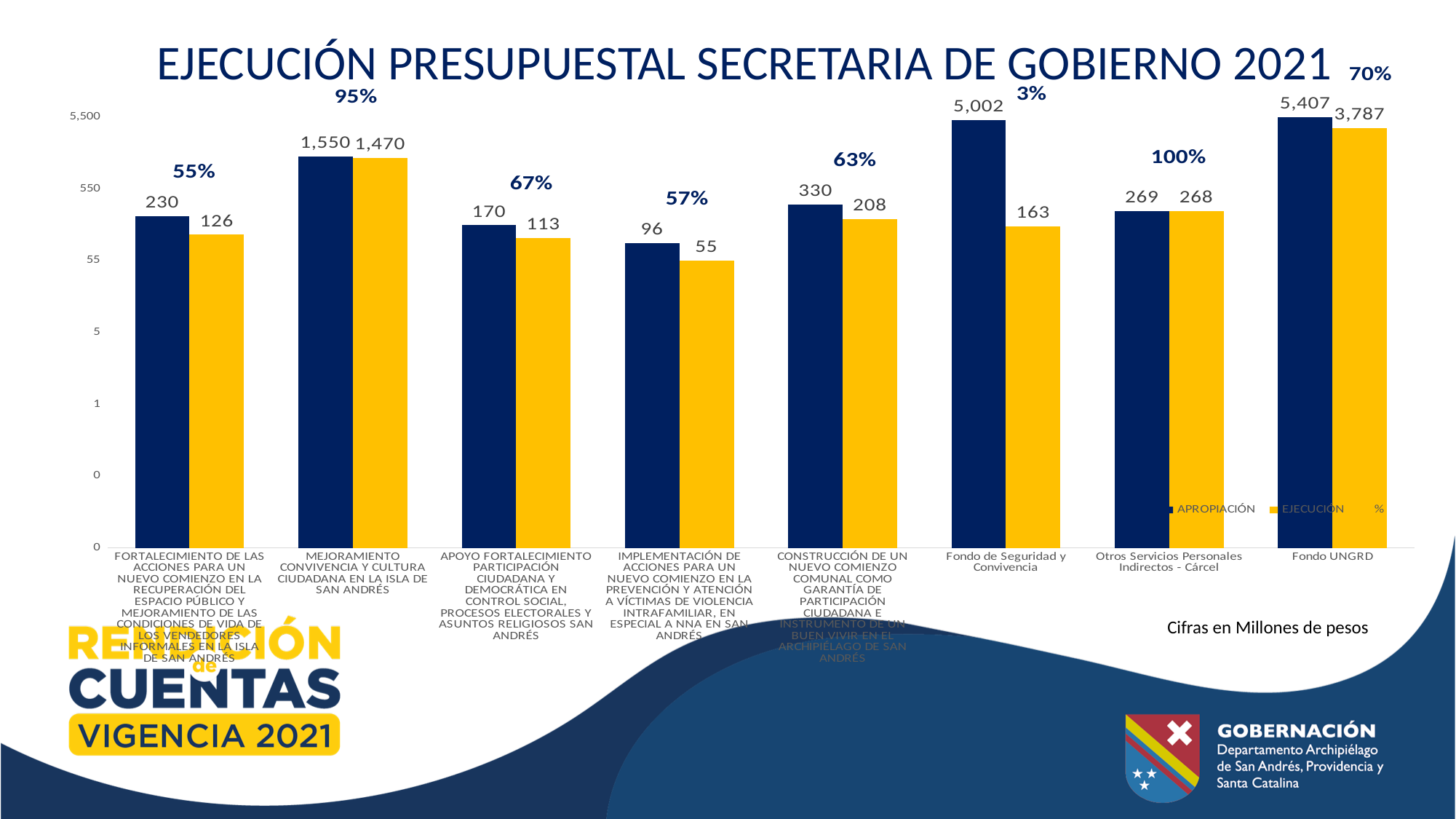
What is the title of the chart? EJECUCIÓN PRESUPUESTAL SECRETARIA DE GOBIERNO 2021 Which category has the lowest EJECUCIÓN value? IMPLEMENTACIÓN DE ACCIONES PARA UN NUEVO COMIENZO EN LA PREVENCIÓN Y ATENCIÓN A VÍCTIMAS DE VIOLENCIA INTRAFAMILIAR, EN ESPECIAL A NNA EN SAN ANDRÉS What is the EJECUCIÓN value for Otros Servicios Personales Indirectos - Cárcel? 268 How many entries does the legend list? 3 How many categories are shown on the x axis? 8 Which category has the highest APROPIACIÓN value? Fondo UNGRD What execution percentage is shown above the bars for Fondo de Seguridad y Convivencia? 3% What is the APROPIACIÓN value for Fondo UNGRD? 5,407 What is the difference between APROPIACIÓN and EJECUCIÓN for Fondo de Seguridad y Convivencia? 4,839 Which is larger: the EJECUCIÓN value for Fondo UNGRD or the APROPIACIÓN value for MEJORAMIENTO CONVIVENCIA Y CULTURA CIUDADANA EN LA ISLA DE SAN ANDRÉS? EJECUCIÓN for Fondo UNGRD What type of chart is shown on the slide? Bar chart What is the EJECUCIÓN value for Fondo de Seguridad y Convivencia? 163